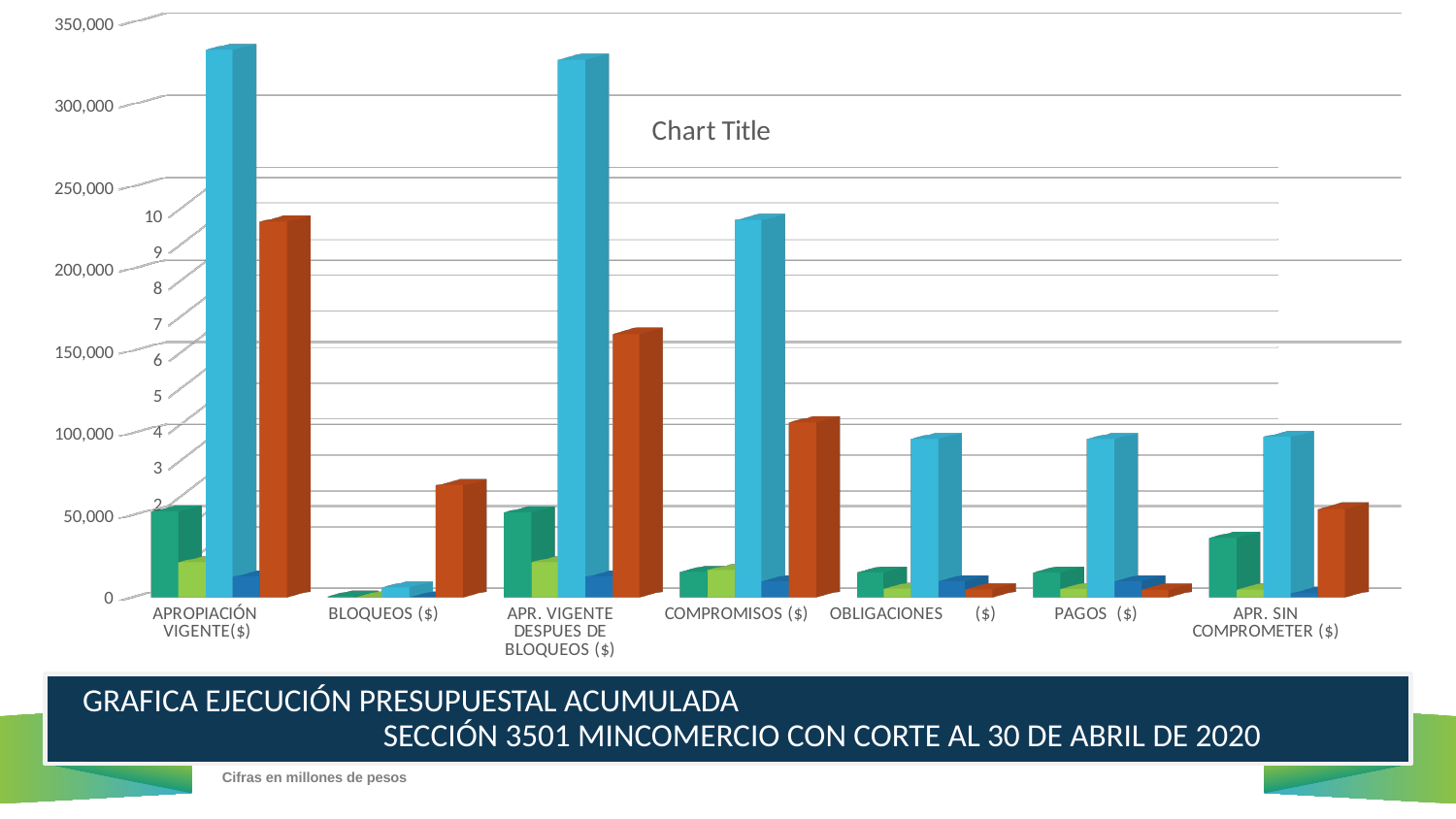
What is the highest value labelled on the vertical axis of the chart? 350,000 Which is larger: the orange bar for APROPIACIÓN VIGENTE($) or the orange bar for APR. VIGENTE DESPUES DE BLOQUEOS ($)? APROPIACIÓN VIGENTE($) What kind of chart is shown on the slide? Bar chart Is the light blue bar for COMPROMISOS ($) greater or less than 200,000? greater Is the orange bar for BLOQUEOS ($) greater or less than 50,000? greater For which category is the light blue bar the lowest? BLOQUEOS ($) For COMPROMISOS ($), which is larger: the light blue bar or the orange bar? The light blue bar Is the orange bar for APR. VIGENTE DESPUES DE BLOQUEOS ($) greater or less than 150,000? greater What is the title printed on the chart? Chart Title How many categories are shown along the x axis of the chart? 7